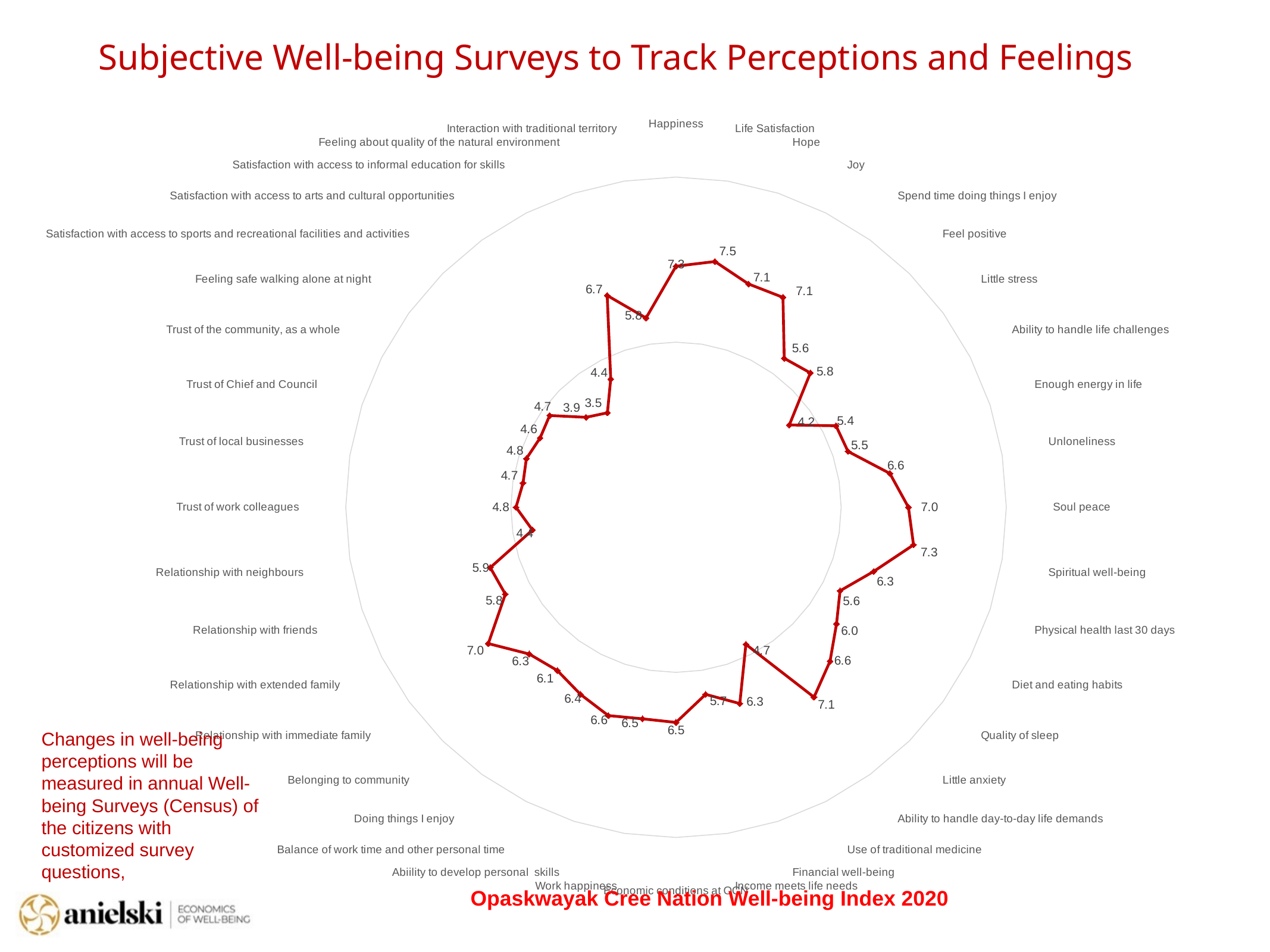
How many categories are plotted on the chart? 40 What is the value for Soul peace? 7.0 Which is larger, the value for Spiritual well-being or the value for Relationship with immediate family? Spiritual well-being Which category has the lowest value? Satisfaction with access to arts and cultural opportunities What is the value for Trust of work colleagues? 4.8 Which category has the highest value? Life Satisfaction What is the value for Economic conditions at OCN? 6.5 What is the value for Spiritual well-being? 7.3 What is the difference between the values for Spiritual well-being and Soul peace? 0.3 What kind of chart is shown on the slide? Radar chart What is the value for Life Satisfaction? 7.5 What is the title shown beneath the chart? Opaskwayak Cree Nation Well-being Index 2020